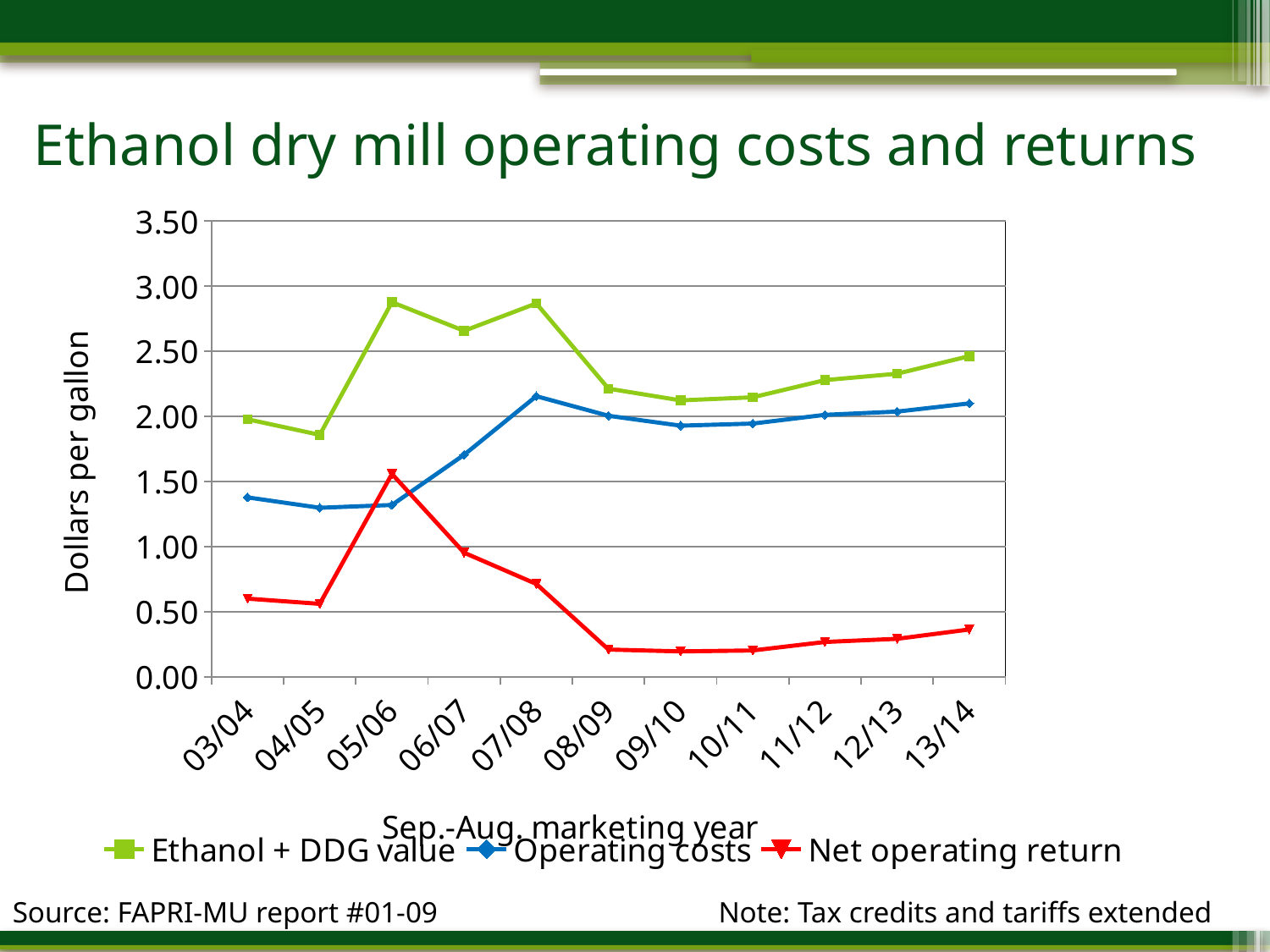
What is the label on the vertical axis? Dollars per gallon How many series does the legend list? 3 Is the Ethanol + DDG value for 05/06 greater or less than 2.50? greater Do Operating costs rise or fall from 03/04 to 07/08? rise Which is larger for Net operating return: 03/04 or 09/10? 03/04 Is the value for Operating costs in 03/04 greater or less than 1.50? less Is the Net operating return for 05/06 greater or less than 1.00? greater In which marketing year is Net operating return highest? 05/06 Which is larger in 03/04: Net operating return or Operating costs? Operating costs What kind of chart is shown on the slide? Line chart How many marketing years are plotted along the x axis? 11